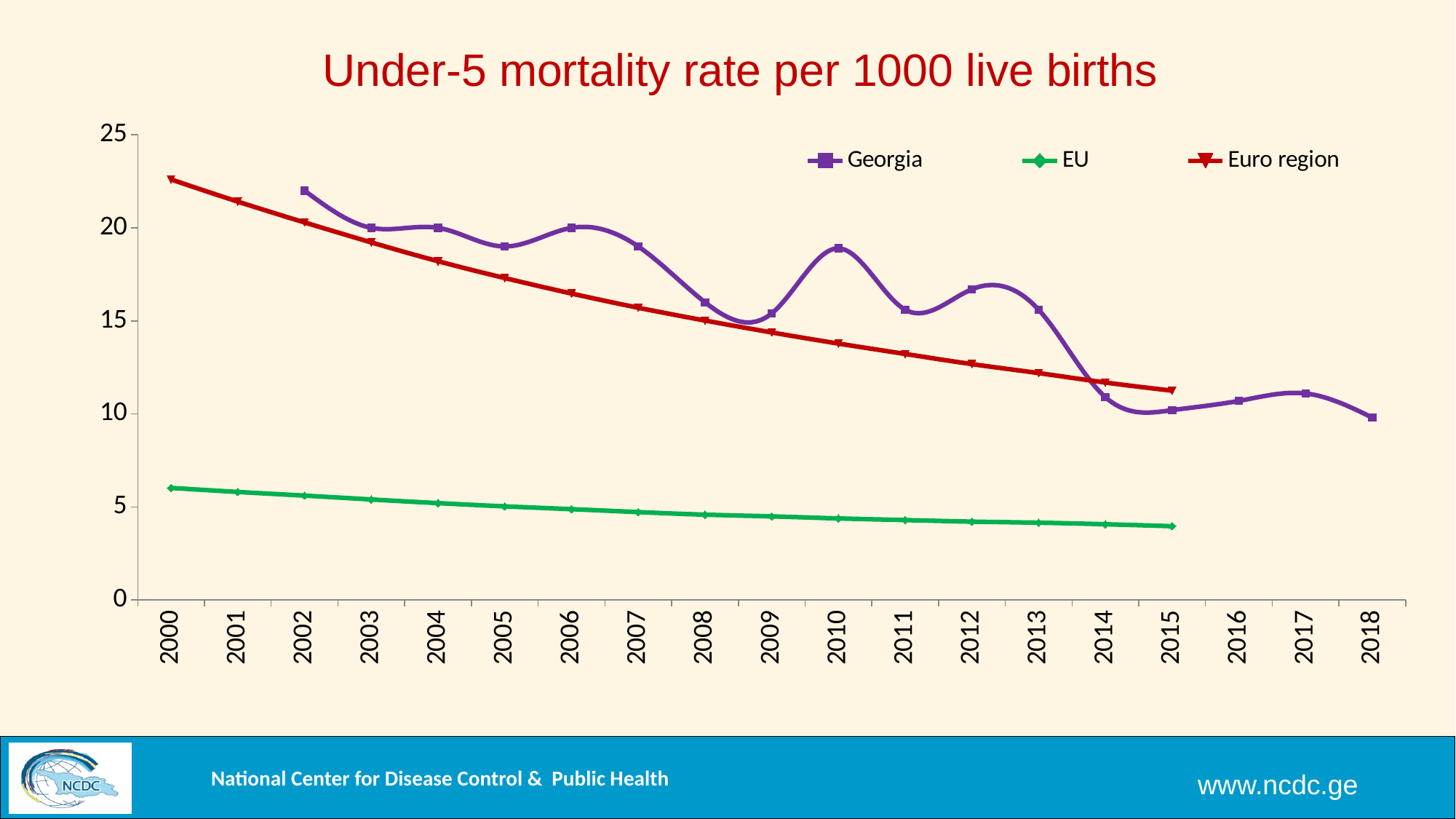
Is the value for EU in 2015 greater or less than 5? less Which series has the lowest values across all years shown? EU In 2010, which is higher, Georgia or Euro region? Georgia Does the EU series rise or fall from 2000 to 2015? Fall Is the value for Euro region in 2000 greater or less than 20? greater Is the value for Georgia in 2002 greater or less than 20? greater Which series is drawn in green? EU What kind of chart is shown on the slide? Line chart How many years are shown on the x axis? 19 How many series does the legend list? 3 What is the title of the chart? Under-5 mortality rate per 1000 live births Does the Euro region series rise or fall from 2000 to 2015? Fall